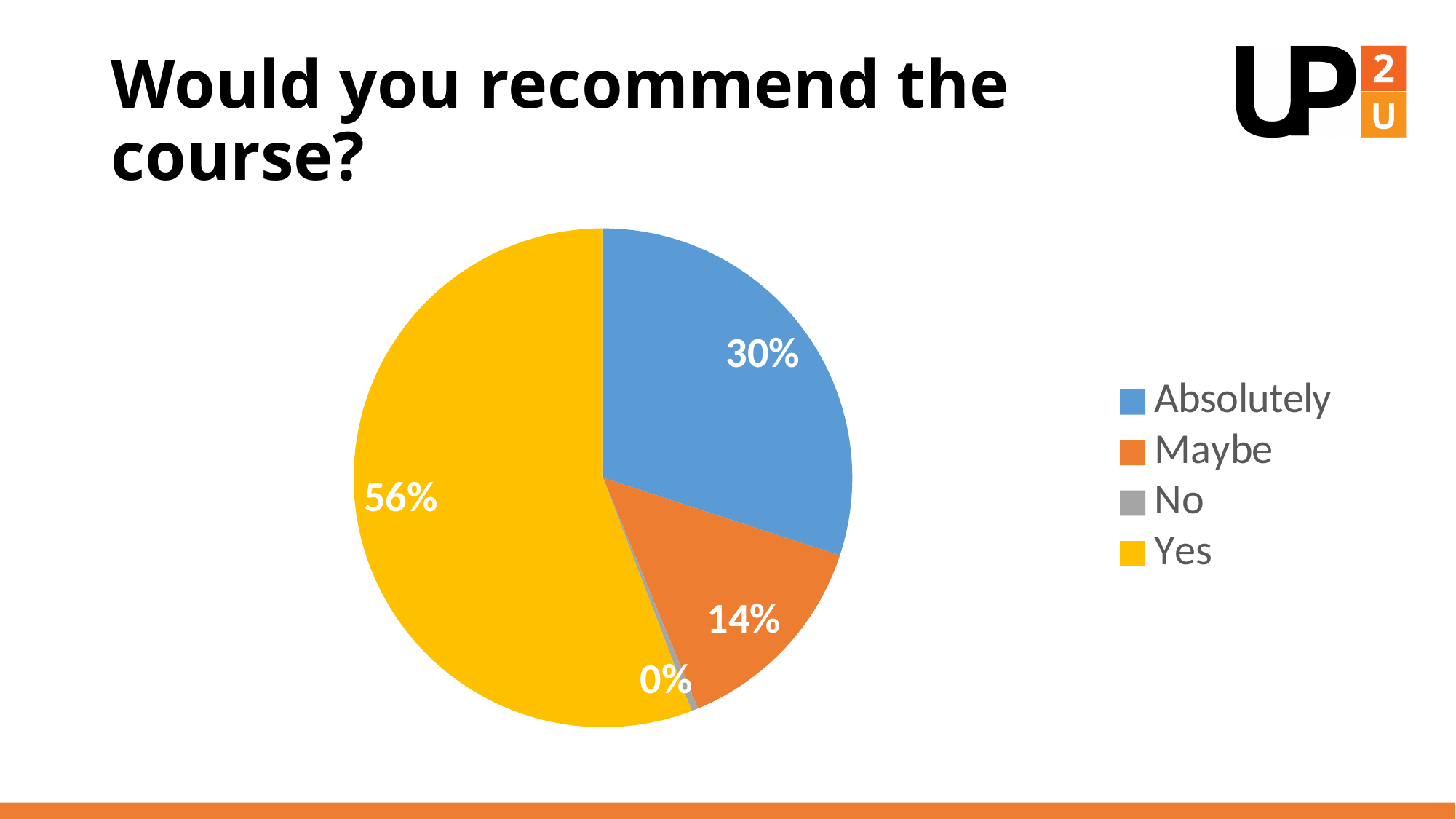
What kind of chart is shown on the slide? pie chart What is the title of the chart? Would you recommend the course? What percentage of respondents answered "No"? 0% Which response has the smallest share of the pie? No Which is larger, the share for "Absolutely" or the share for "Maybe"? Absolutely What percentage of respondents answered "Absolutely"? 30% What percentage of respondents answered "Maybe"? 14% Which response has the largest share of the pie? Yes How many categories does the legend list? 4 What colour is the "Yes" slice? yellow What is the difference in percentage points between "Yes" and "Absolutely"? 26 What percentage of respondents answered "Yes"? 56%